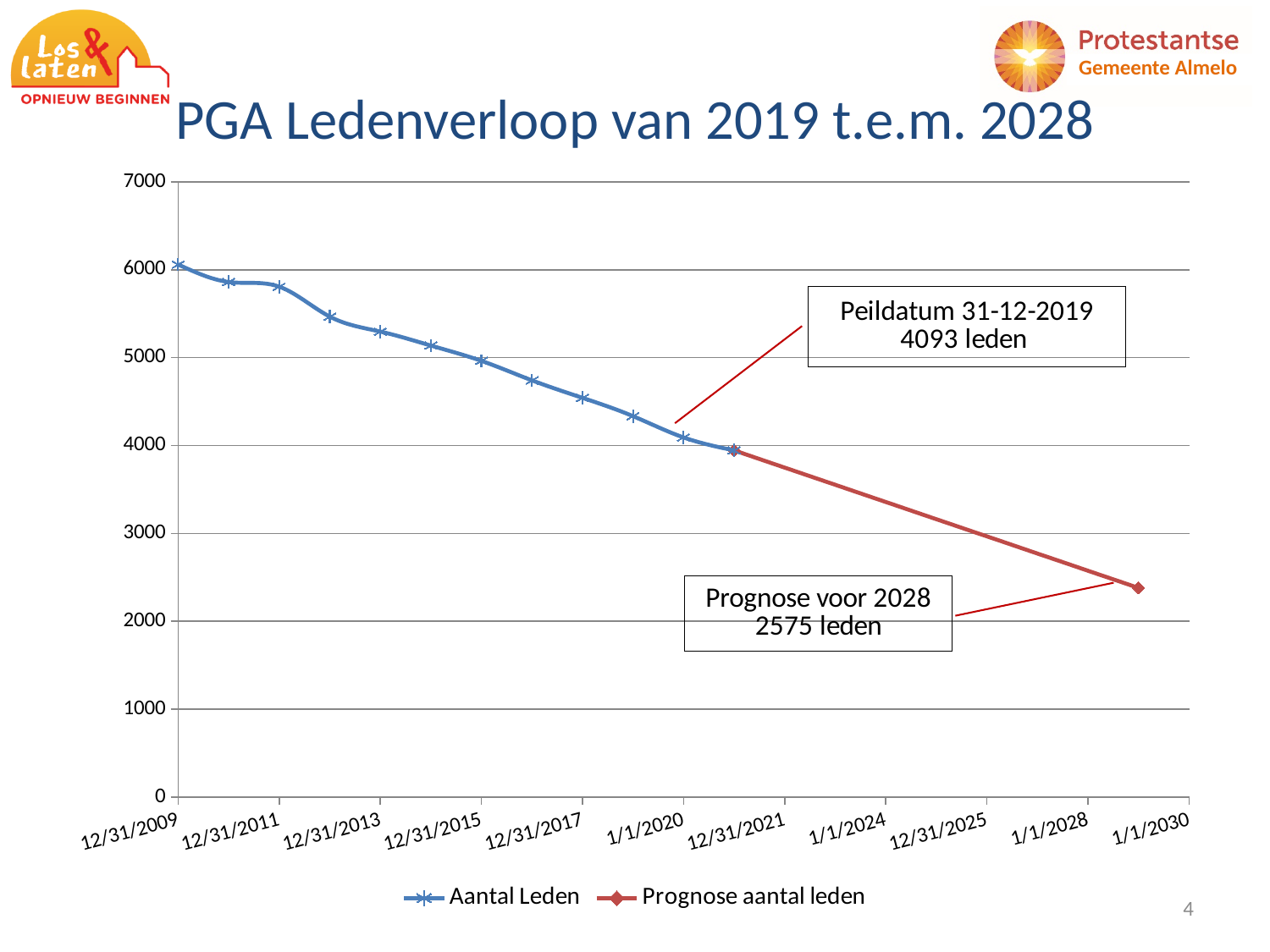
According to the annotation, what is the prognose (forecast) number of members for 2028? 2575 leden According to the annotation, how many members (leden) were there on the peildatum 31-12-2019? 4093 leden What kind of chart is shown on the slide? line chart What is the difference between the number of members on 31-12-2019 (4093) and the prognose for 2028 (2575)? 1518 What is the title of the chart? PGA Ledenverloop van 2019 t.e.m. 2028 How many series does the legend list? 2 Do the values of the Aantal Leden series rise or fall along the x axis? fall Is the value for Aantal Leden at 12/31/2017 greater or less than 5000? less Is the final value of the Prognose aantal leden series greater or less than 3000? less Is the value for Aantal Leden at 12/31/2009 greater or less than 5000? greater What are the two series named in the legend? Aantal Leden and Prognose aantal leden Which is larger: the number of members on 31-12-2019 or the prognose for 2028? the number of members on 31-12-2019